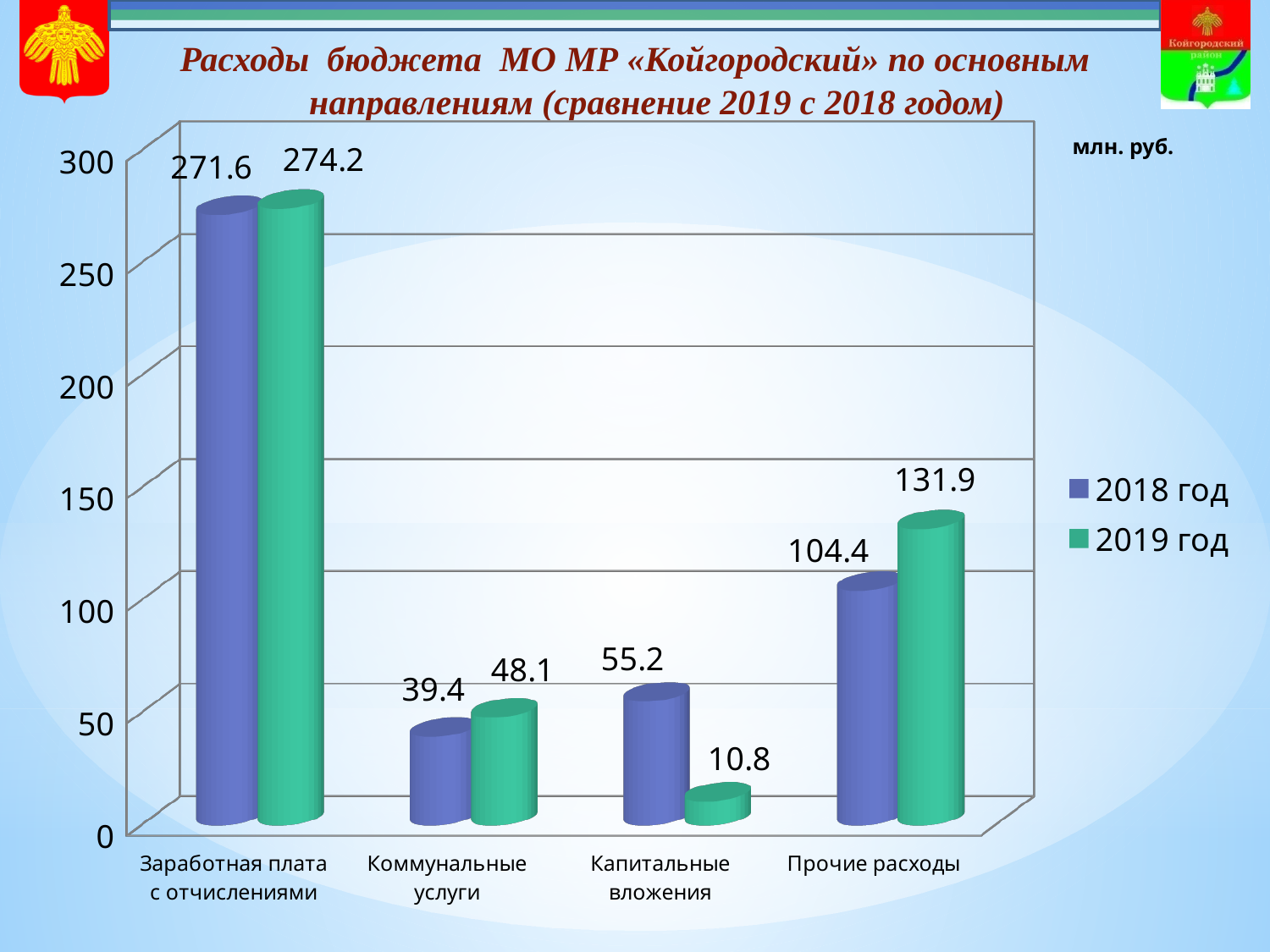
What is the value for Коммунальные услуги in 2018 год? 39.4 Which is larger for Капитальные вложения: the 2018 год value or the 2019 год value? 2018 год Which category has the highest value in 2018 год? Заработная плата с отчислениями How many categories are shown on the x axis? 4 What kind of chart is shown on the slide? bar chart Which category has the lowest value in 2019 год? Капитальные вложения What is the difference between the 2019 год and 2018 год values for Прочие расходы? 27.5 How many series does the legend list? 2 What is the value for Капитальные вложения in 2018 год? 55.2 What is the value for Заработная плата с отчислениями in 2019 год? 274.2 What unit is indicated for the values on the chart? млн. руб. What is the value for Прочие расходы in 2019 год? 131.9